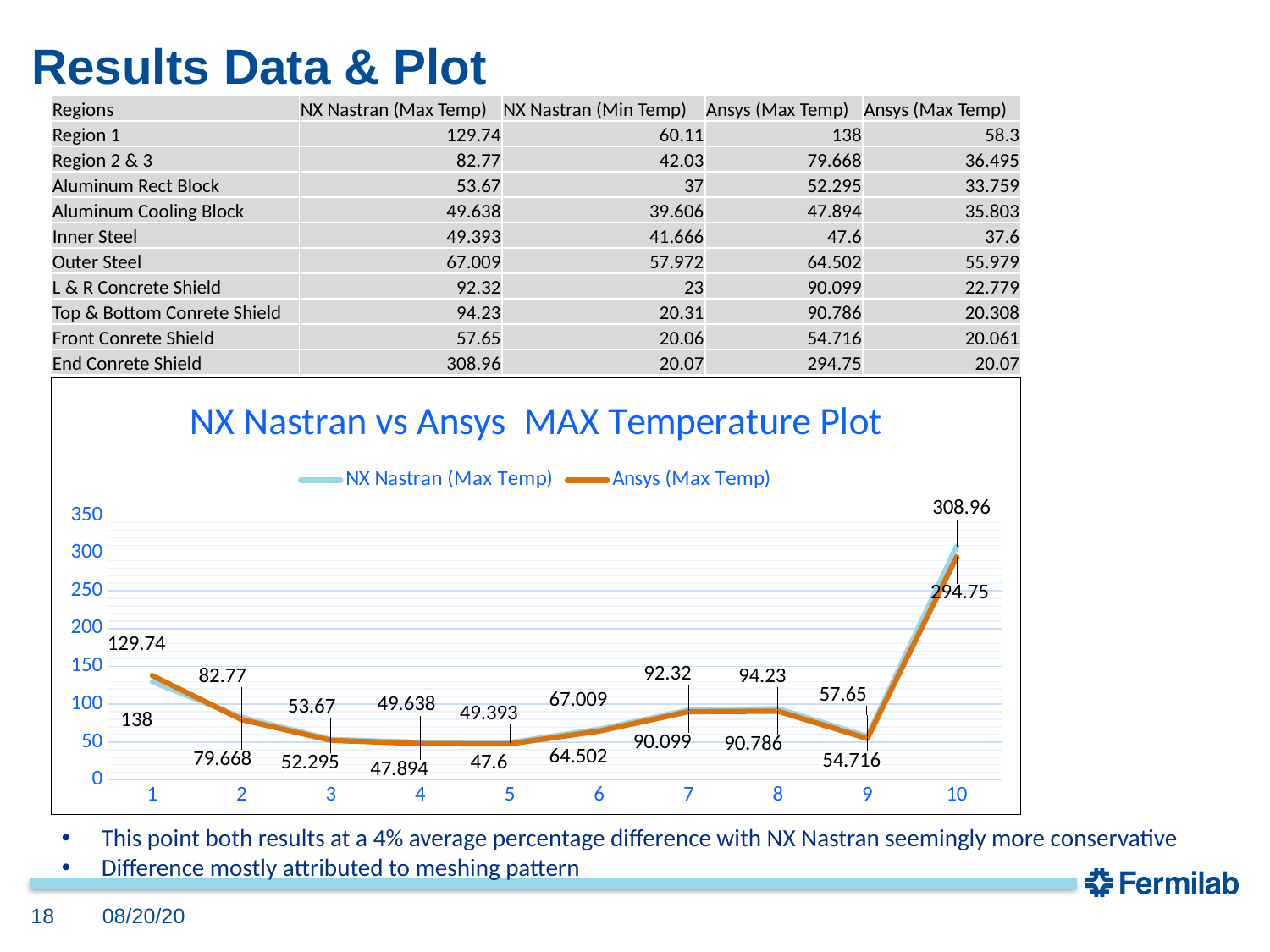
What is the title of the chart? NX Nastran vs Ansys MAX Temperature Plot How many series does the chart legend list? 2 At which x-axis point is the Ansys (Max Temp) value lowest? 5 What type of chart is shown on the slide? line chart What is the difference between the NX Nastran (Max Temp) and Ansys (Max Temp) values at point 10? 14.21 At which x-axis point is the NX Nastran (Max Temp) value highest? 10 What is the NX Nastran (Max Temp) value at point 10? 308.96 What is the Ansys (Max Temp) value at point 1? 138 What is the Ansys (Max Temp) value at point 6? 64.502 Is the NX Nastran (Max Temp) value at point 10 greater or less than 300? greater How many points are plotted along the x axis for each series? 10 Which series has the larger value at point 1, NX Nastran (Max Temp) or Ansys (Max Temp)? Ansys (Max Temp)